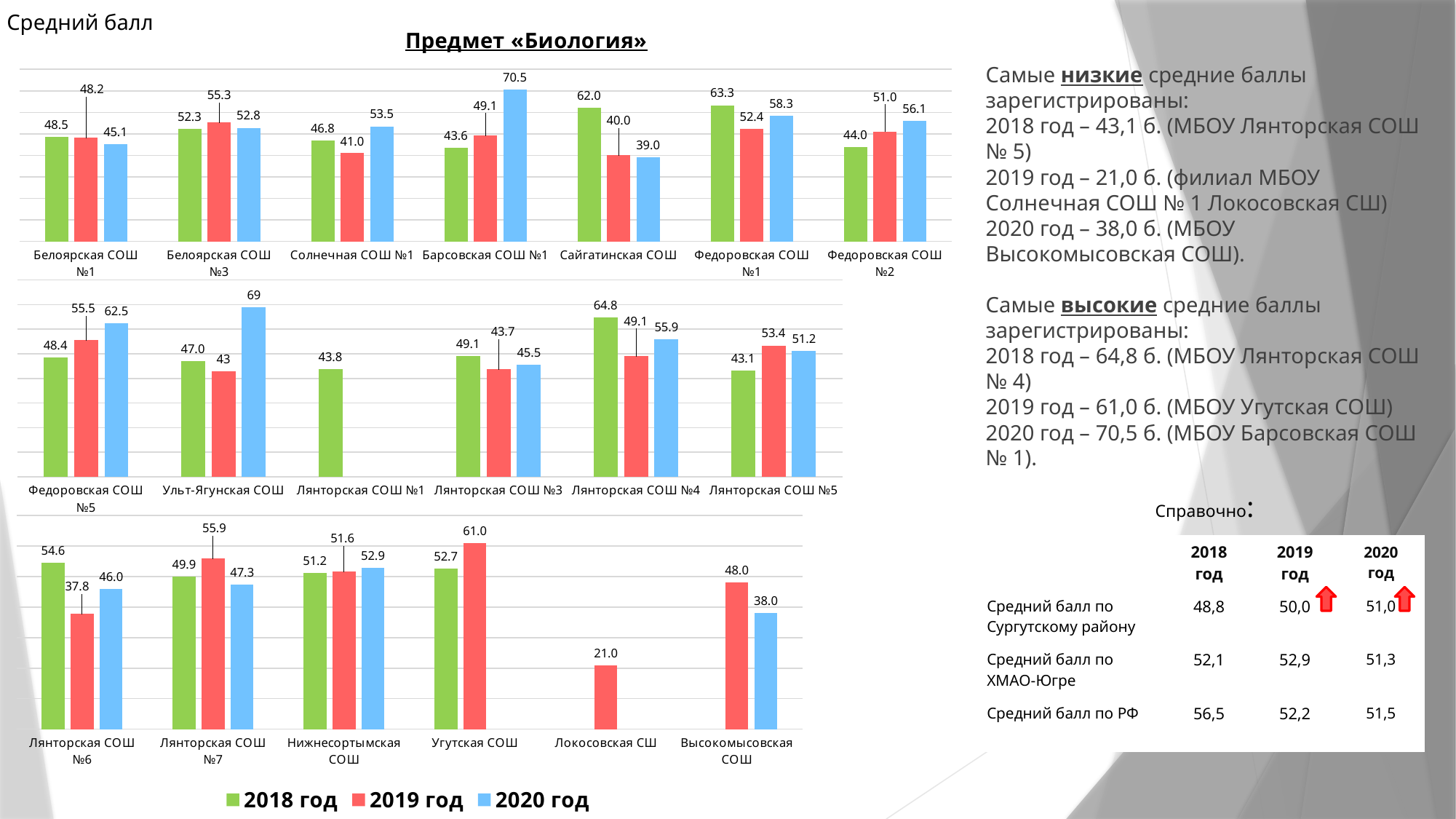
In the middle chart, which school has the highest 2018 год value? Лянторская СОШ №4 In the top chart, what is the 2019 год value for Сайгатинская СОШ? 40.0 In the middle chart, what is the 2020 год value for Ульт-Ягунская СОШ? 69 In the top chart, what is the difference between the 2020 год and 2018 год values for Федоровская СОШ №2? 12.1 In the bottom chart, which school has the lowest 2019 год value? Локосовская СШ In the middle chart, which is larger for Лянторская СОШ №5: the 2019 год value or the 2020 год value? 2019 год How many series does the legend list? 3 In the top chart, which school has the highest 2018 год value? Федоровская СОШ №1 In the bottom chart, do the values for Нижнесортымская СОШ rise or fall from 2018 год to 2020 год? rise In the bottom chart, what is the 2019 год value for Локосовская СШ? 21.0 In the top chart, what is the 2020 год value for Барсовская СОШ №1? 70.5 What kind of chart is the top chart? bar chart